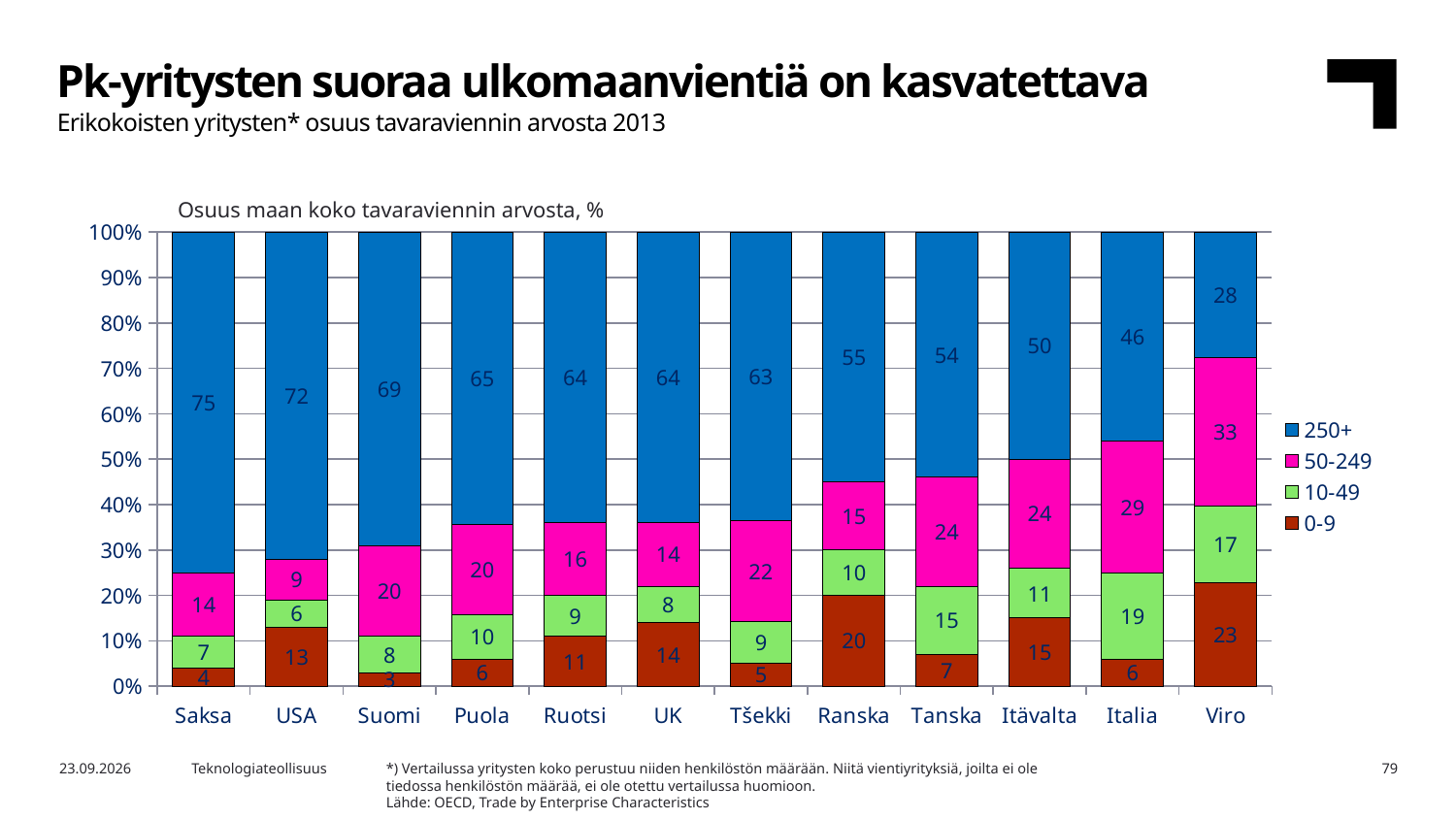
Which country has the highest value in the 250+ series? Saksa What is the difference between the 250+ values for Saksa and Viro? 47 Which country has the lowest value in the 0-9 series? Suomi Which country has the lowest value in the 250+ series? Viro What is the value of the 0-9 series for Viro? 23 How many series does the legend list? 4 What is the value of the 250+ series for Saksa? 75 How many countries are shown on the x axis? 12 What is the value of the 10-49 series for Tanska? 15 Which is larger: the 0-9 value for Ranska or the 0-9 value for Tanska? Ranska What is the value of the 50-249 series for Italia? 29 What kind of chart is shown on the slide? Stacked bar chart